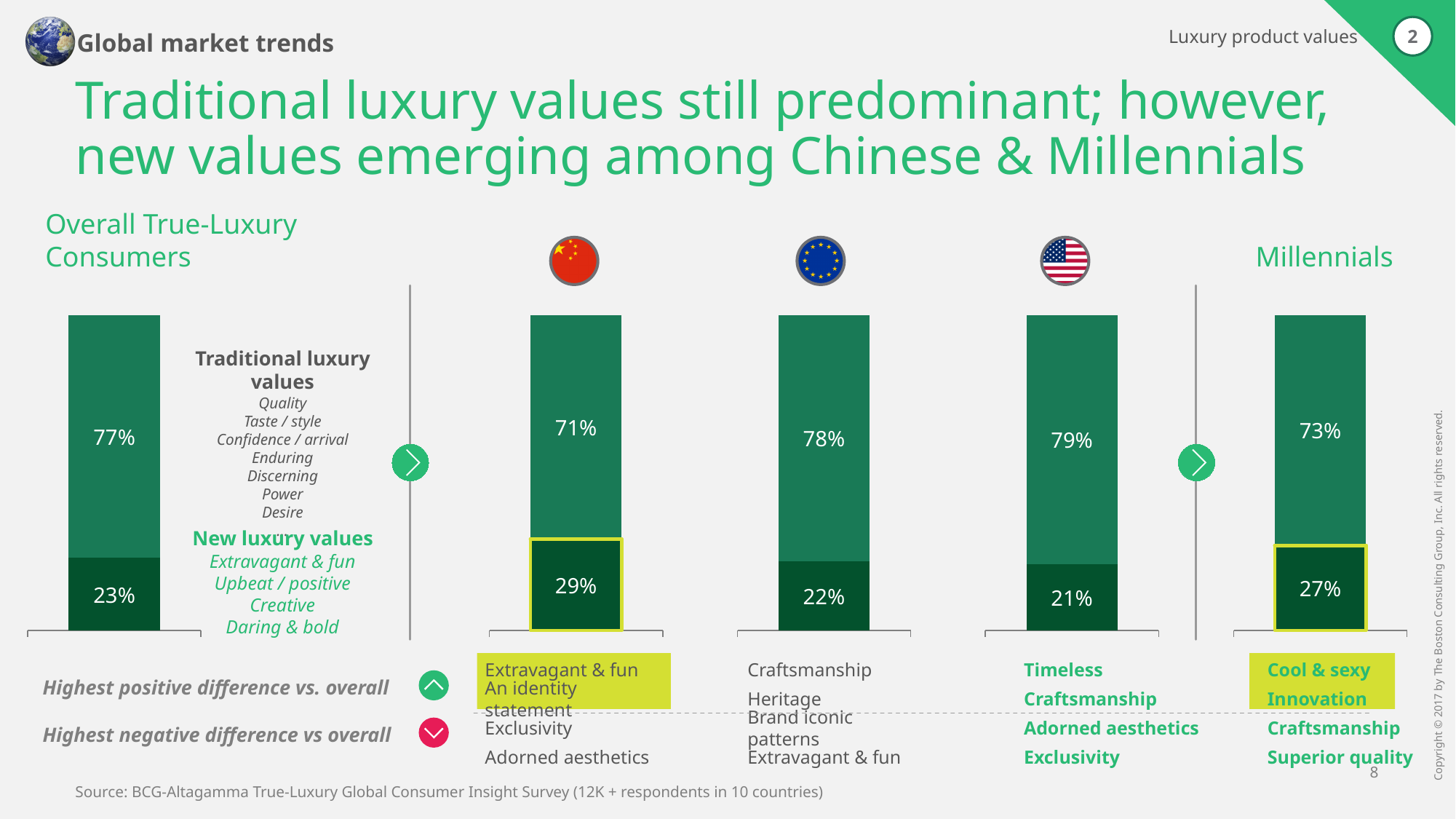
Which group has the highest share for new luxury values? China What is the new luxury values share for the US (American flag) bar? 21% What is the traditional luxury values share for the China (Chinese flag) bar? 71% How many percentage points higher is the new luxury values share for China than for Overall True-Luxury Consumers? 6 percentage points Which group has the lowest share for new luxury values? US What kind of chart is shown on the slide? Stacked bar chart What is the total of the two segments in the Overall True-Luxury Consumers bar? 100% Which has a larger traditional luxury values share, the EU bar or the Millennials bar? EU How many bars are shown in the chart? 5 How many segments make up each stacked bar? 2 What share of Overall True-Luxury Consumers is attributed to traditional luxury values? 77% What share of Millennials is attributed to new luxury values? 27%